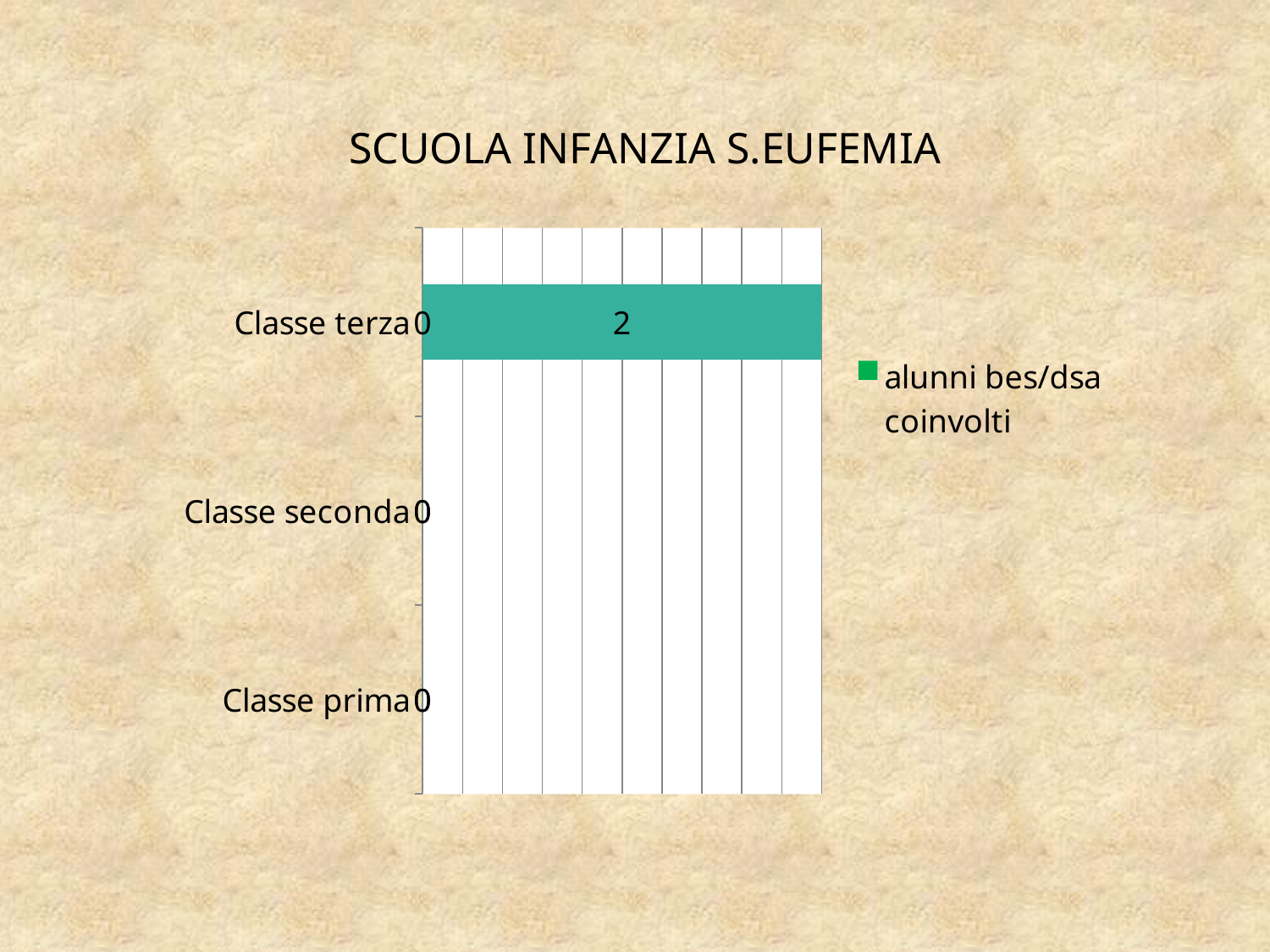
Which has a larger value, Classe terza or Classe seconda? Classe terza What is the name of the series shown in the legend? alunni bes/dsa coinvolti What type of chart is shown on the slide? bar chart What is the value for Classe prima? 0 How many series does the legend list? 1 Which class has the highest value? Classe terza What is the value for Classe seconda? 0 What is the title of the chart? SCUOLA INFANZIA S.EUFEMIA How many classes (categories) are shown on the chart? 3